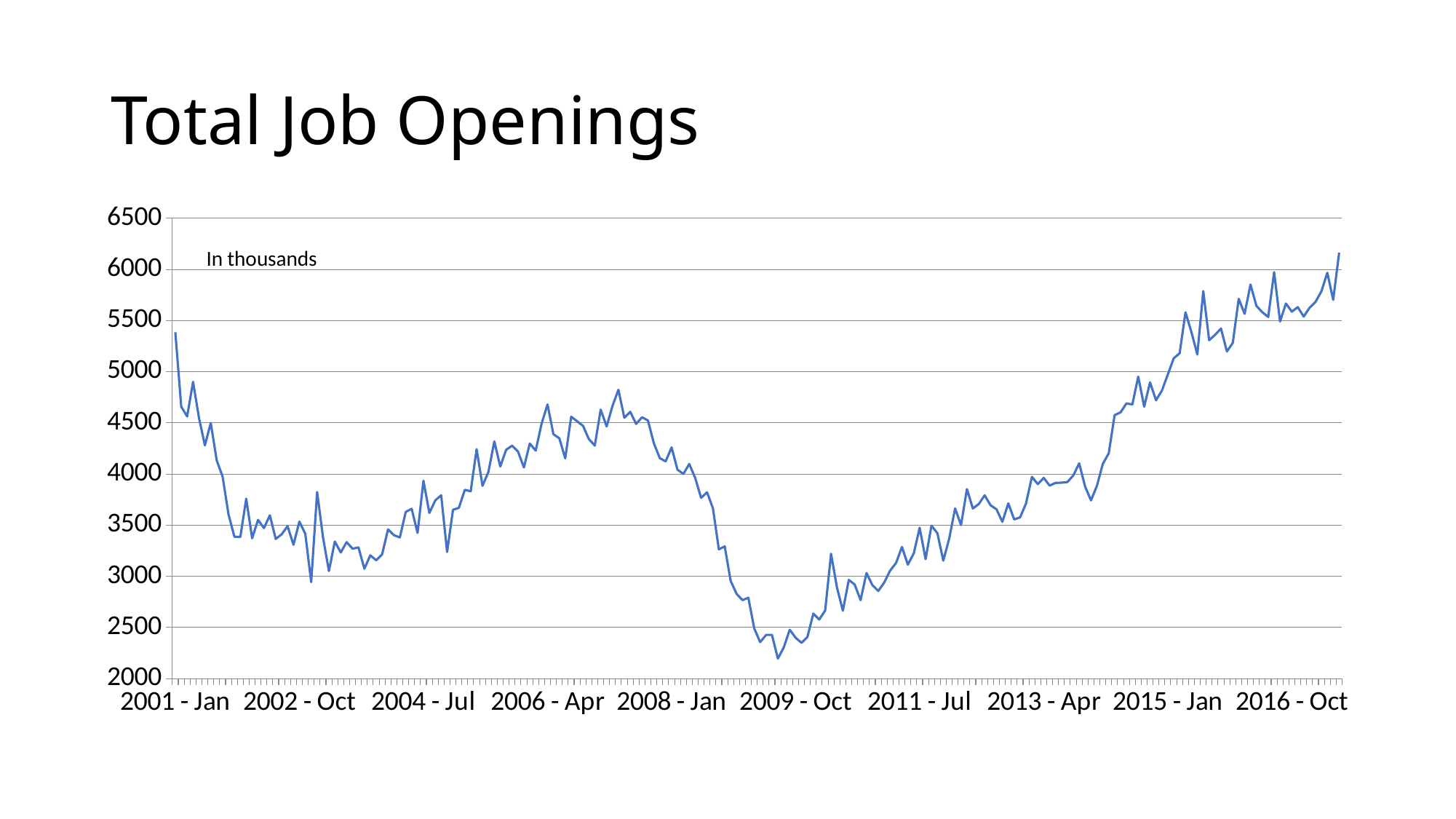
What is the title of the chart? Total Job Openings Is the value at 2016 - Oct greater or less than 6000? less In what units are the values plotted, according to the note inside the chart? In thousands Does the line rise or fall between 2008 - Jan and 2009 - Oct? fall Which of the two is larger: the value at 2016 - Oct or the value at 2001 - Jan? 2016 - Oct Is the value at 2004 - Jul greater or less than 3500? greater Is the value at 2009 - Oct greater or less than 2500? less Does the line rise or fall between 2009 - Oct and 2016 - Oct? rise What kind of chart is shown on the slide? line chart